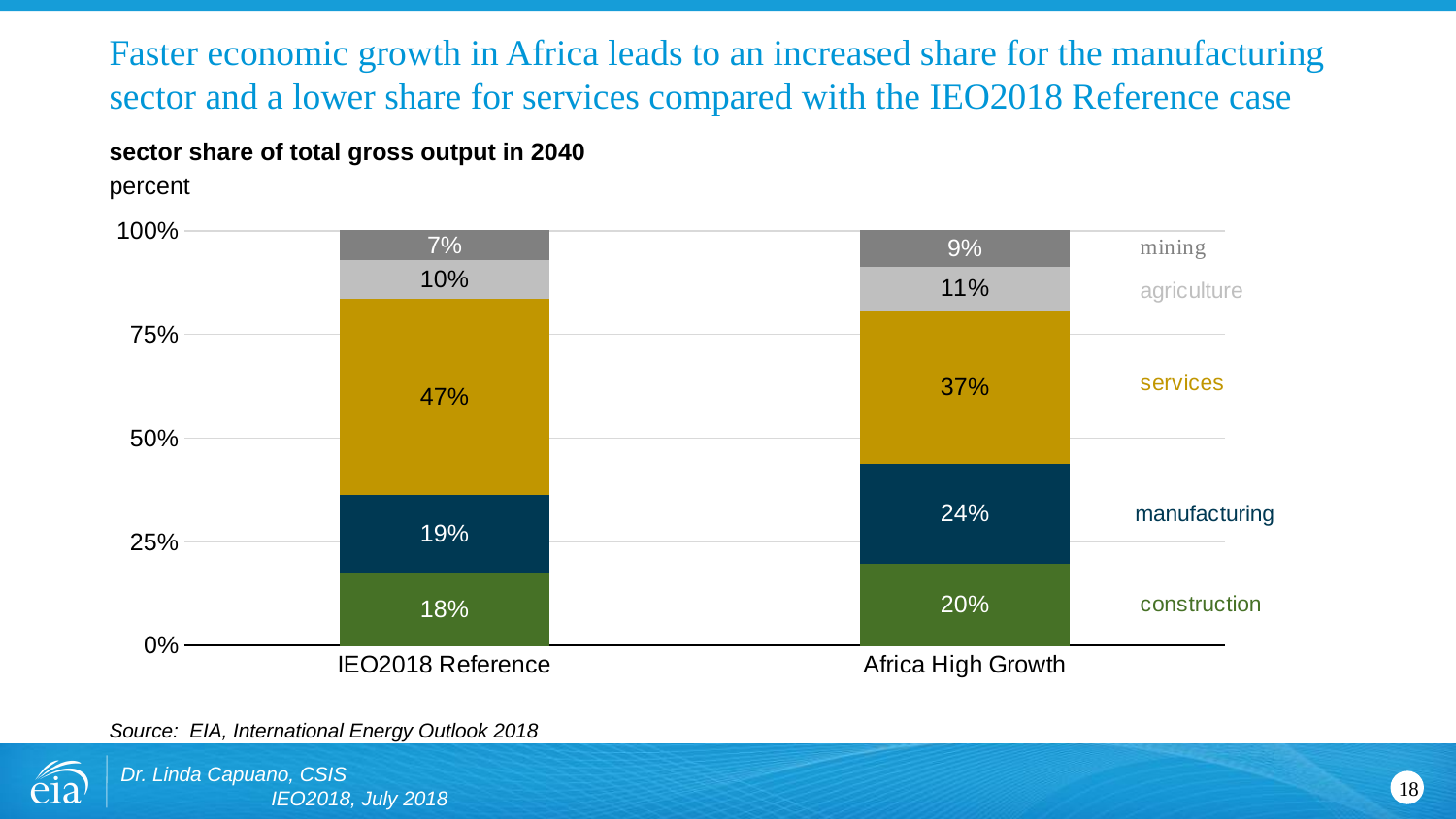
How many percentage points higher is the services share in the IEO2018 Reference case than in the Africa High Growth case? 10 How many sectors are listed in the chart's legend? 5 What is the manufacturing share of total gross output in 2040 in the Africa High Growth case? 24% What type of chart is shown on the slide? stacked bar chart What is the mining share in the Africa High Growth case? 9% What is the services share of total gross output in 2040 in the IEO2018 Reference case? 47% What is the unit shown below the chart title? percent Which sector has the smallest share in the IEO2018 Reference case? mining Which sector has the largest share in the Africa High Growth case? services What is the construction share in the IEO2018 Reference case? 18% Which case has the larger manufacturing share, IEO2018 Reference or Africa High Growth? Africa High Growth How many cases (bars) are shown on the chart? 2